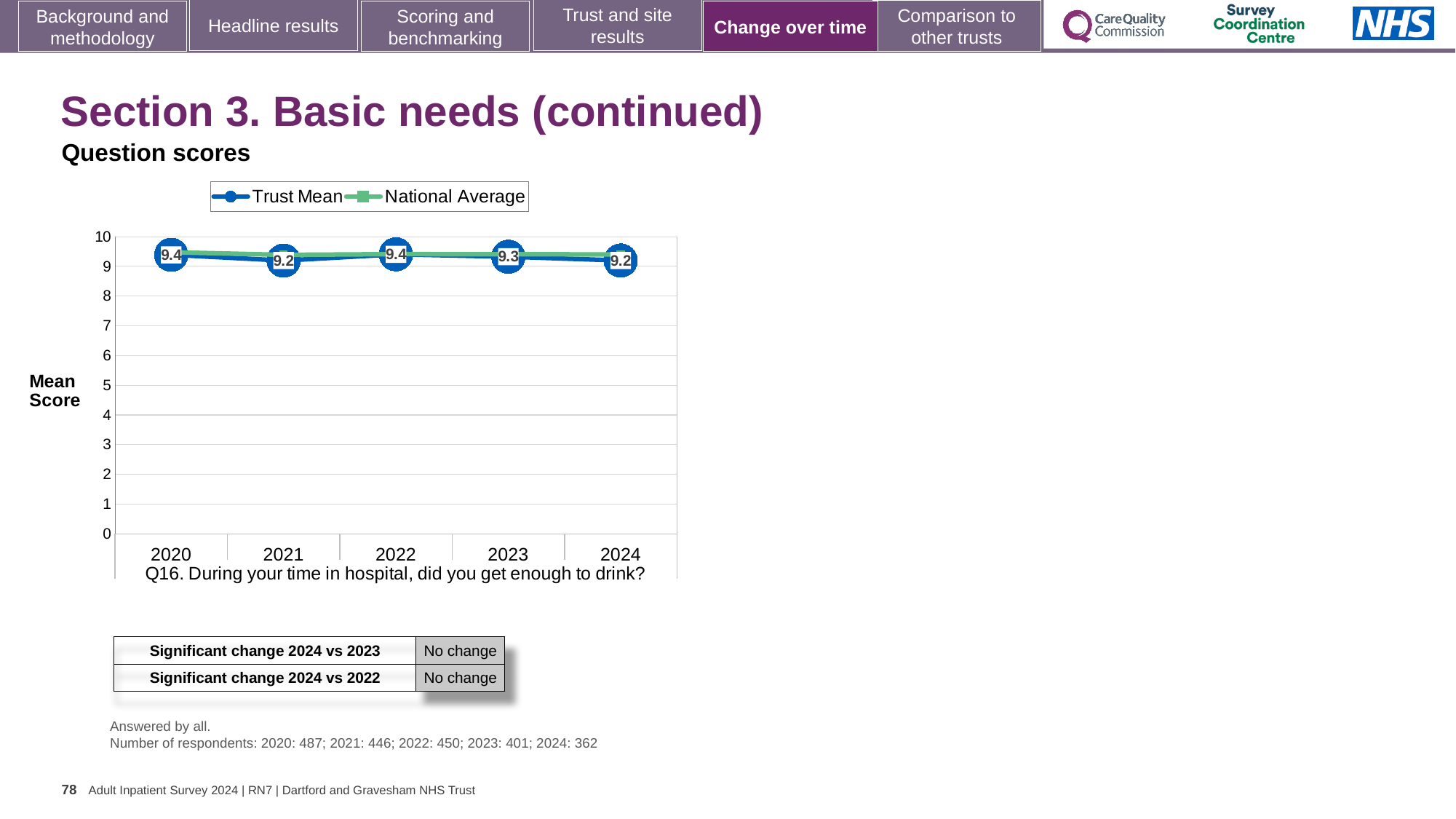
Does the Trust Mean score rise or fall from 2023 to 2024? fall What is the label on the y axis of the chart? Mean Score What is the Trust Mean score for 2020? 9.4 What is the Trust Mean score for 2021? 9.2 How many years are shown on the x axis of the chart? 5 Which year has the larger Trust Mean score, 2022 or 2024? 2022 What is the difference between the Trust Mean scores for 2020 and 2021? 0.2 Is the National Average value for 2024 greater or less than 8? greater What kind of chart is shown on the slide? line chart What is the Trust Mean score for 2023? 9.3 How many series does the chart legend list? 2 What is the Trust Mean score for 2024? 9.2